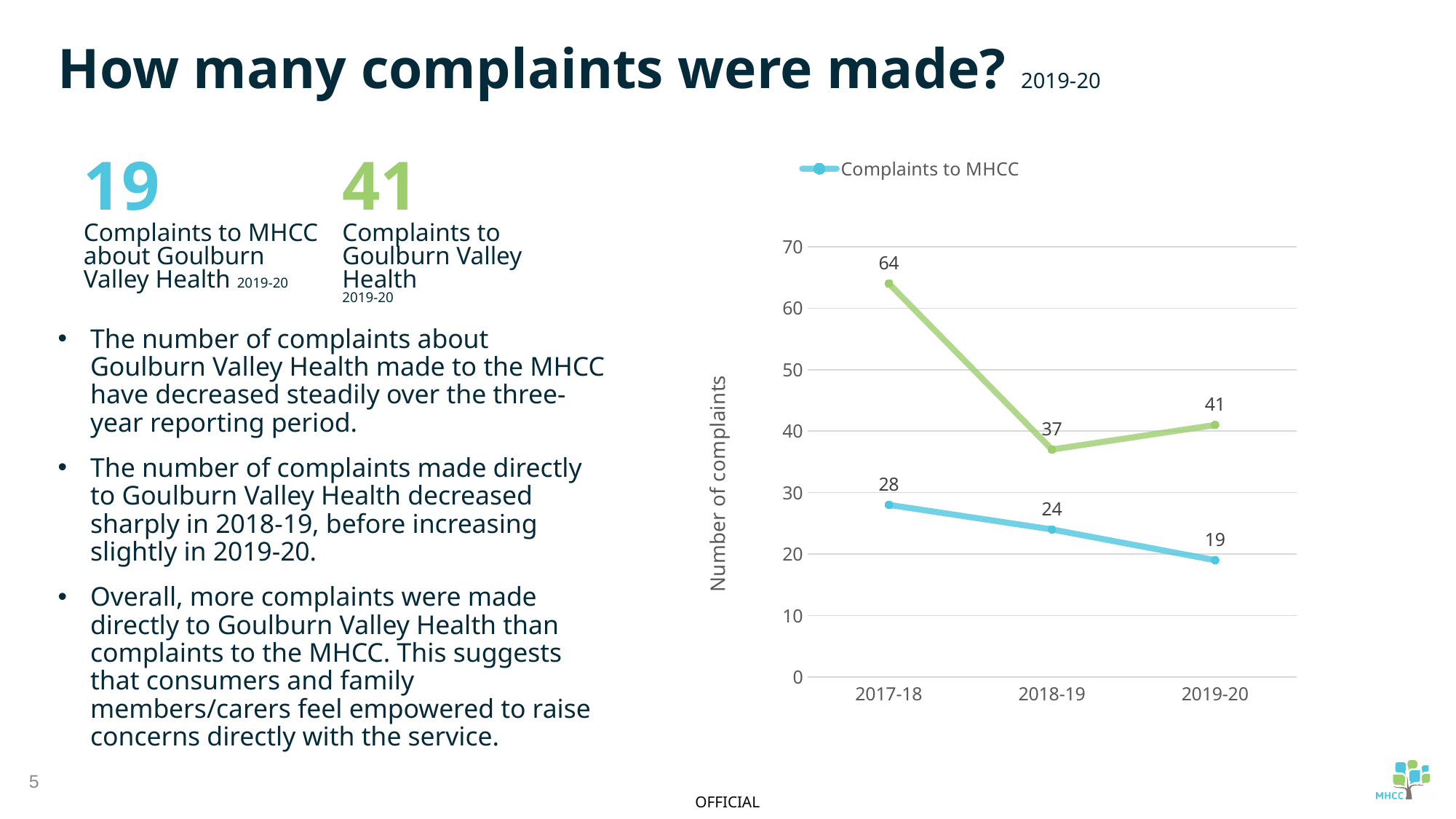
Which is larger in 2019-20: the green line or Complaints to MHCC? The green line What is the difference between the green line's values in 2017-18 and 2018-19? 27 What is the value of the green line in 2018-19? 37 Does Complaints to MHCC rise or fall from 2017-18 to 2019-20? Fall What is the value of the green line in 2017-18? 64 What is the value for Complaints to MHCC in 2019-20? 19 In which year is Complaints to MHCC lowest? 2019-20 What is the difference between Complaints to MHCC in 2017-18 and 2019-20? 9 What is the value for Complaints to MHCC in 2017-18? 28 How many years are shown on the x axis? 3 In which year is the green line highest? 2017-18 What kind of chart is shown? Line chart